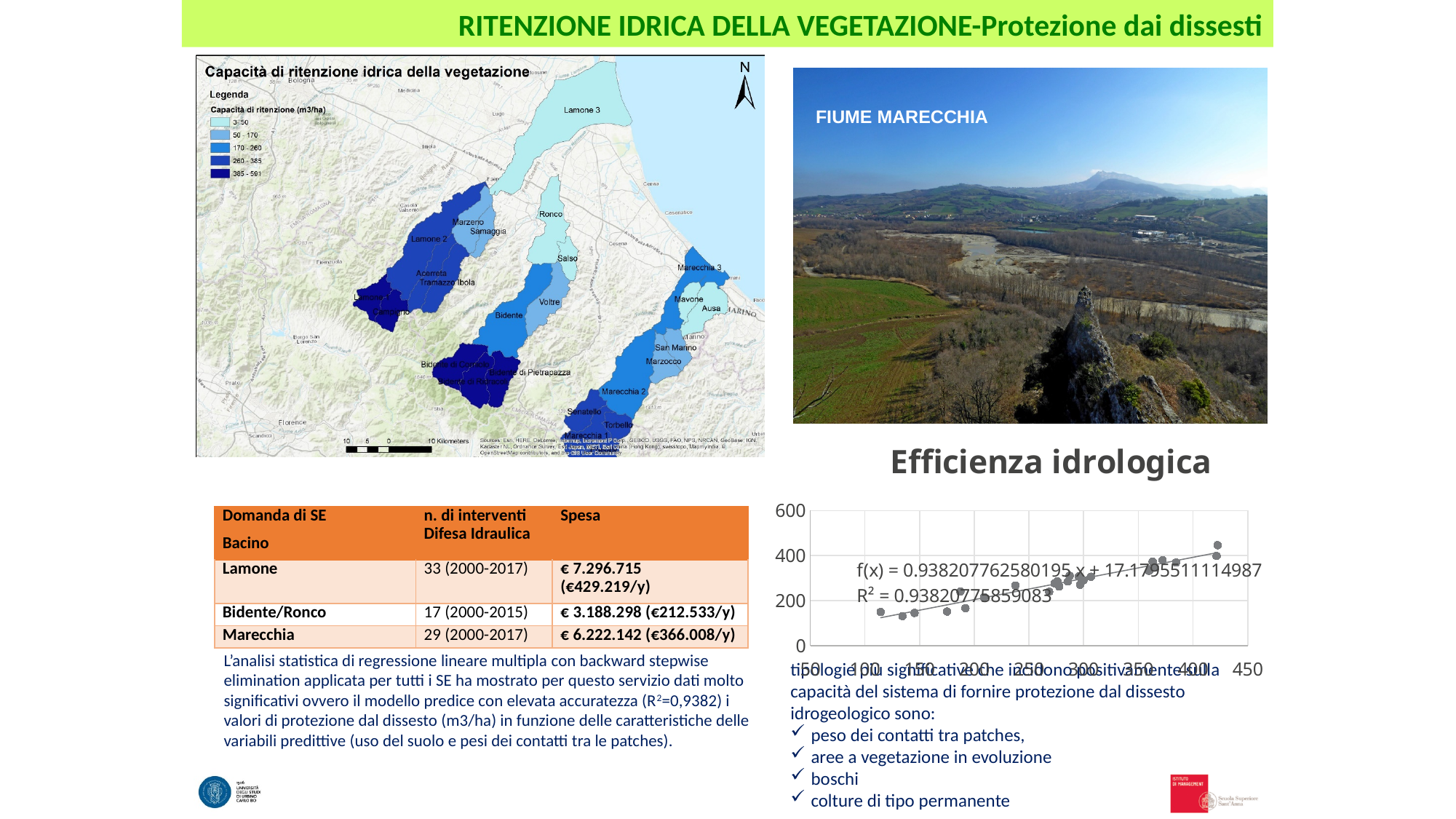
In the 'Efficienza idrologica' chart, is the highest plotted point greater or less than 400? greater What is the title of the scatter chart on the slide? Efficienza idrologica In the 'Efficienza idrologica' chart, do the plotted values rise or fall as the x-axis values increase? rise What kind of chart is the 'Efficienza idrologica' chart? scatter chart What R² value is shown on the 'Efficienza idrologica' chart? R² = 0.938207758859083 In the 'Efficienza idrologica' chart, is the lowest plotted point greater or less than 200? less